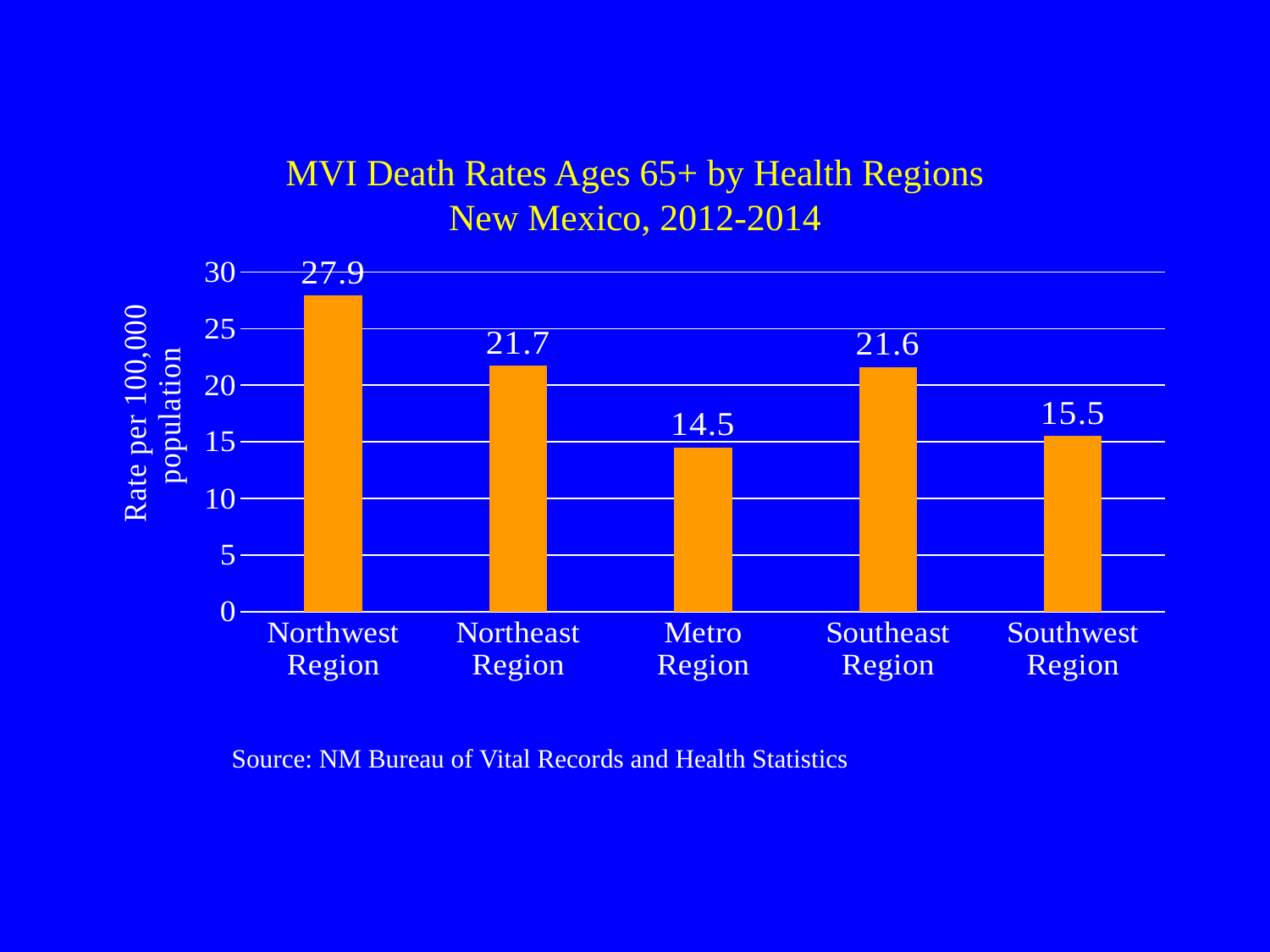
What kind of chart is shown on the slide? bar chart Is the value for the Northwest Region greater or less than 25? greater Which has a higher MVI death rate, the Southeast Region or the Southwest Region? Southeast Region How many health regions are shown in the chart? 5 What is the difference between the MVI death rates of the Northwest Region and the Metro Region? 13.4 What is the MVI death rate for the Northwest Region? 27.9 What is the MVI death rate for the Metro Region? 14.5 What is the MVI death rate for the Southwest Region? 15.5 Which region has the lowest MVI death rate? Metro Region What is the label of the vertical axis? Rate per 100,000 population What is the difference between the MVI death rates of the Northeast Region and the Southwest Region? 6.2 Which region has the highest MVI death rate? Northwest Region